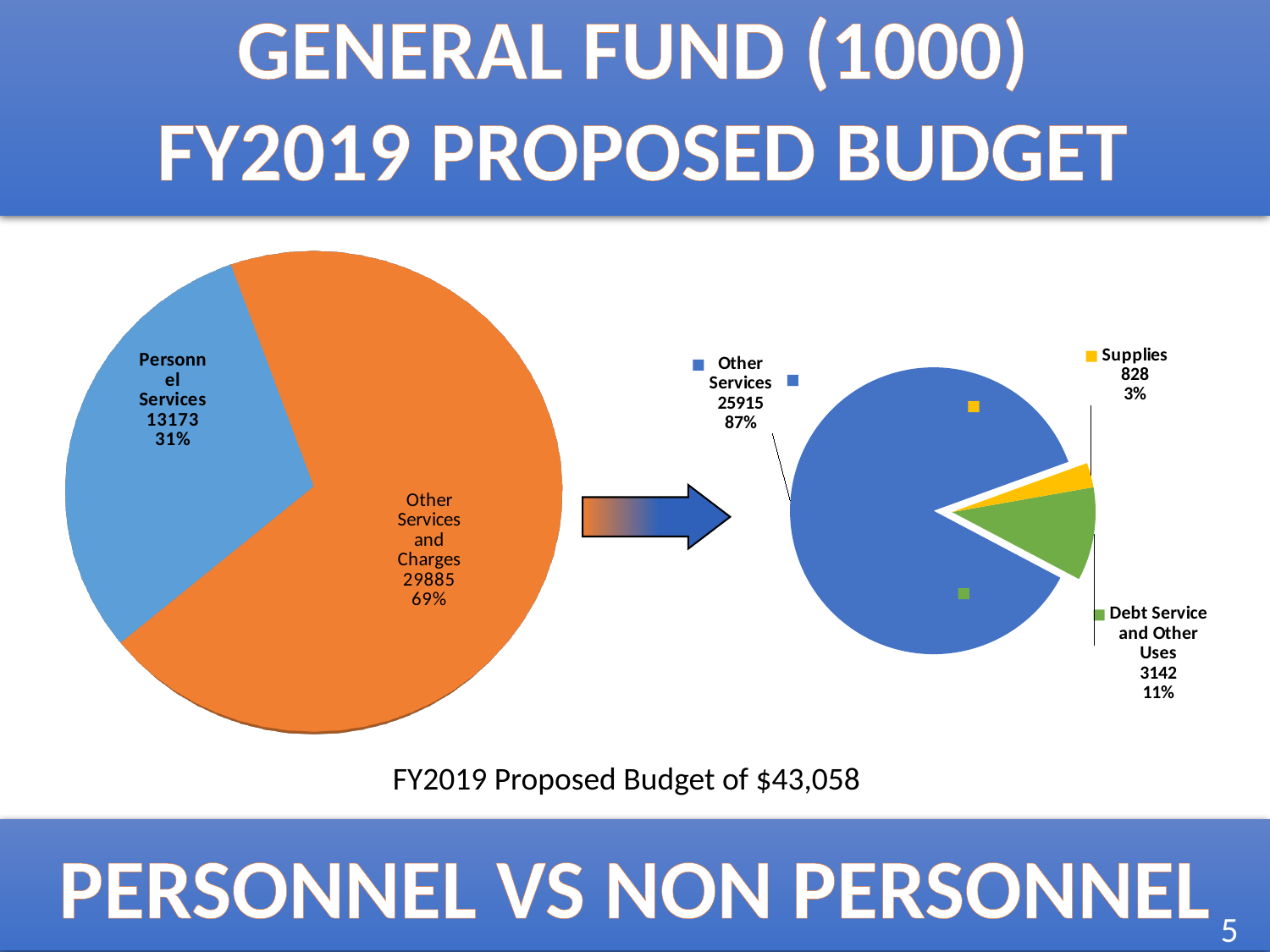
On the right pie chart, what is the value for Supplies? 828 On the right pie chart, which category is the smallest? Supplies How many categories does the right pie chart show? 3 What kind of chart is the left chart on the slide? Pie chart On the left pie chart, what share of the pie is Other Services and Charges? 69% On the right pie chart, what share of the pie is Debt Service and Other Uses? 11% On the left pie chart, what is the value for Personnel Services? 13173 On the right pie chart, which is larger, Debt Service and Other Uses or Supplies? Debt Service and Other Uses On the right pie chart, what is the value for Other Services? 25915 On the left pie chart, which category is the largest? Other Services and Charges On the right pie chart, what is the difference between Debt Service and Other Uses and Supplies? 2314 On the left pie chart, what is the difference between Other Services and Charges and Personnel Services? 16712